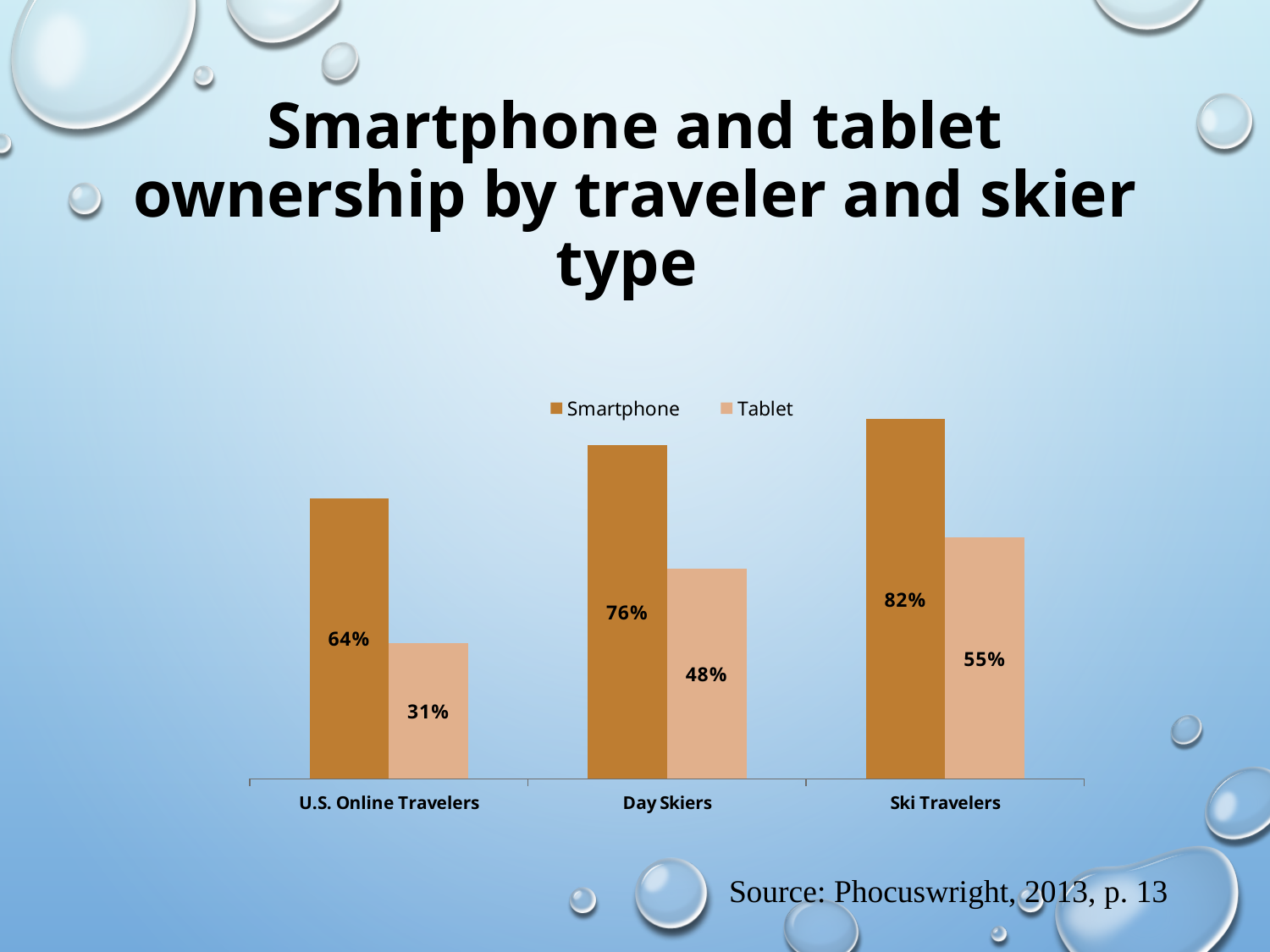
What is the smartphone ownership value for Ski Travelers? 82% What is the difference in tablet ownership between Day Skiers and U.S. Online Travelers? 17% How many series does the legend list? 2 Which category has the highest smartphone ownership? Ski Travelers Which category has the lowest tablet ownership? U.S. Online Travelers What is the tablet ownership value for Day Skiers? 48% Which is larger: tablet ownership for Ski Travelers or smartphone ownership for U.S. Online Travelers? Smartphone ownership for U.S. Online Travelers What is the smartphone ownership value for U.S. Online Travelers? 64% What kind of chart is shown on the slide? Bar chart How many categories are shown on the x axis? 3 What is the difference between smartphone and tablet ownership for Ski Travelers? 27% What is the tablet ownership value for U.S. Online Travelers? 31%